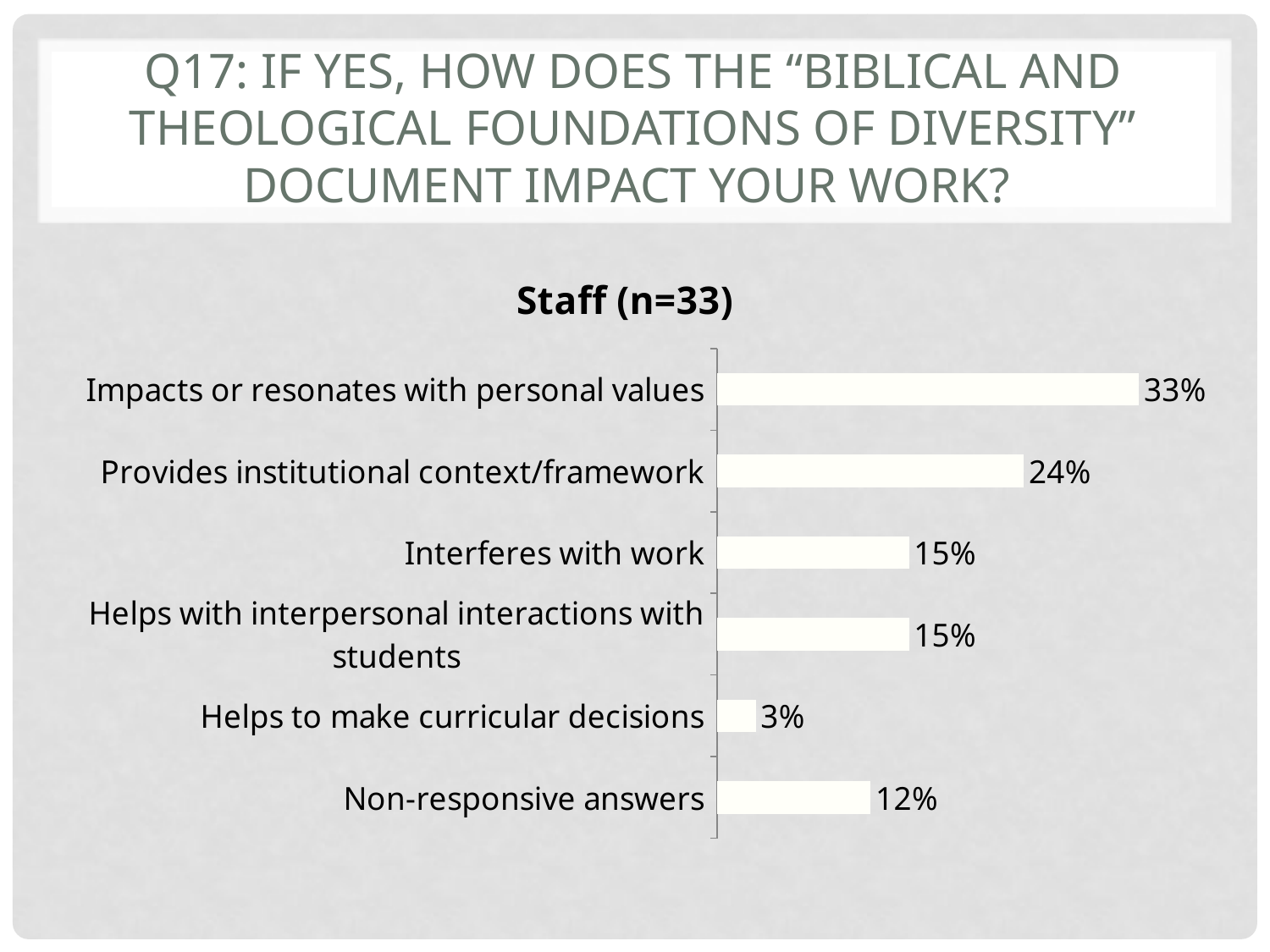
What kind of chart is shown on the slide? Bar chart What percentage of staff said the document impacts or resonates with personal values? 33% What is the difference between "Interferes with work" and "Helps to make curricular decisions"? 12% What is the title of the chart? Staff (n=33) What is the value for "Provides institutional context/framework"? 24% What is the difference between "Impacts or resonates with personal values" and "Provides institutional context/framework"? 9% What is the value for "Non-responsive answers"? 12% Which category has the lowest value? Helps to make curricular decisions Which is larger: "Interferes with work" or "Non-responsive answers"? Interferes with work Which category has the highest value? Impacts or resonates with personal values How many categories are shown in the chart? 6 What percentage is shown for "Helps to make curricular decisions"? 3%